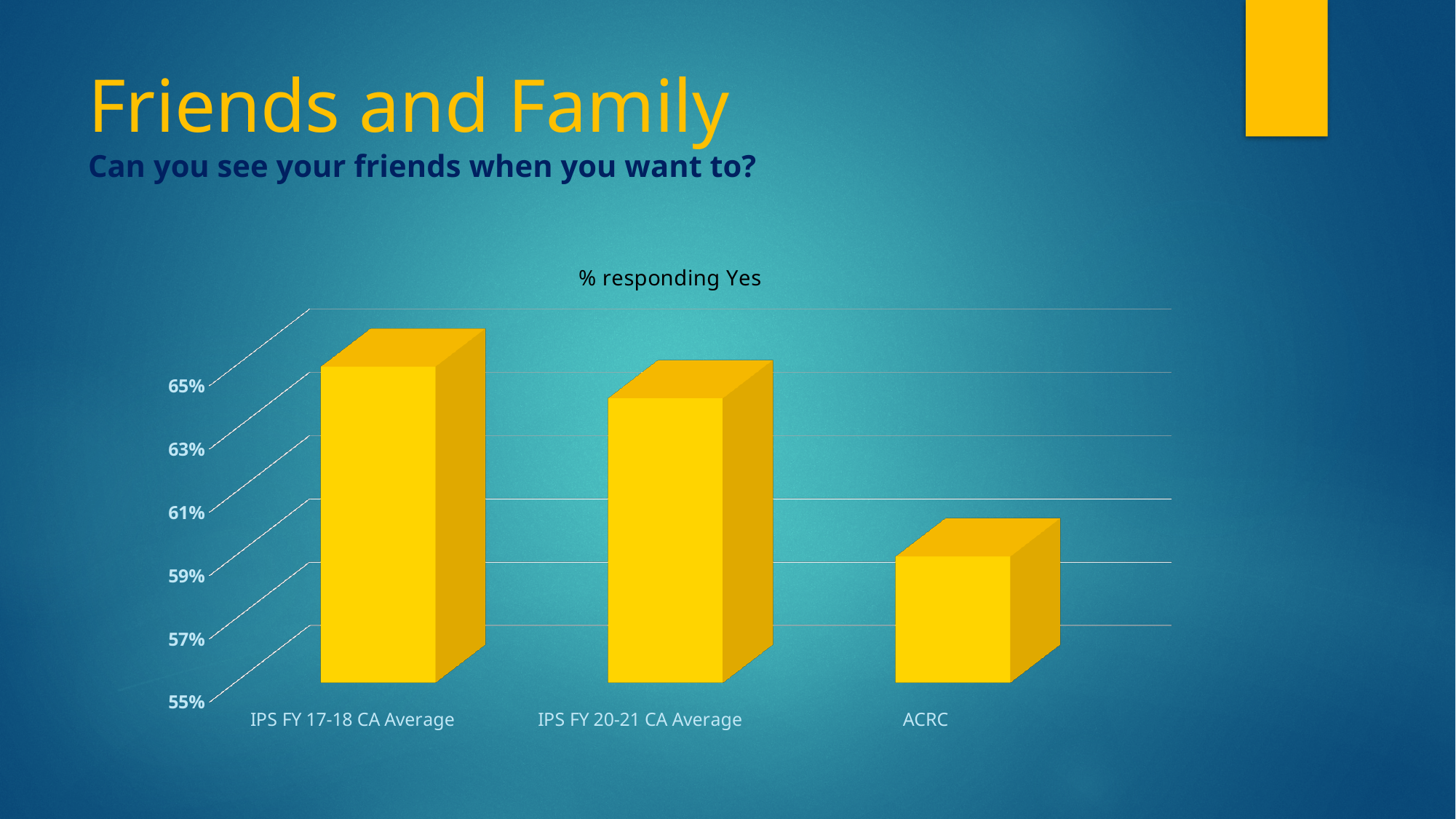
Do the values rise or fall moving from left to right across the categories? Fall Which category has the lowest value in the chart? ACRC Is the value for IPS FY 17-18 CA Average greater or less than 63%? greater What is the title of the chart? % responding Yes What kind of chart is shown on the slide? Bar chart Which is larger, the value for IPS FY 20-21 CA Average or the value for ACRC? IPS FY 20-21 CA Average How many categories are plotted in the chart? 3 Which category has the highest value in the chart? IPS FY 17-18 CA Average Is the value for ACRC greater or less than 61%? less Is the value for IPS FY 20-21 CA Average greater or less than 61%? greater Which is larger, the value for IPS FY 17-18 CA Average or the value for IPS FY 20-21 CA Average? IPS FY 17-18 CA Average What colour are the bars in the chart? Yellow